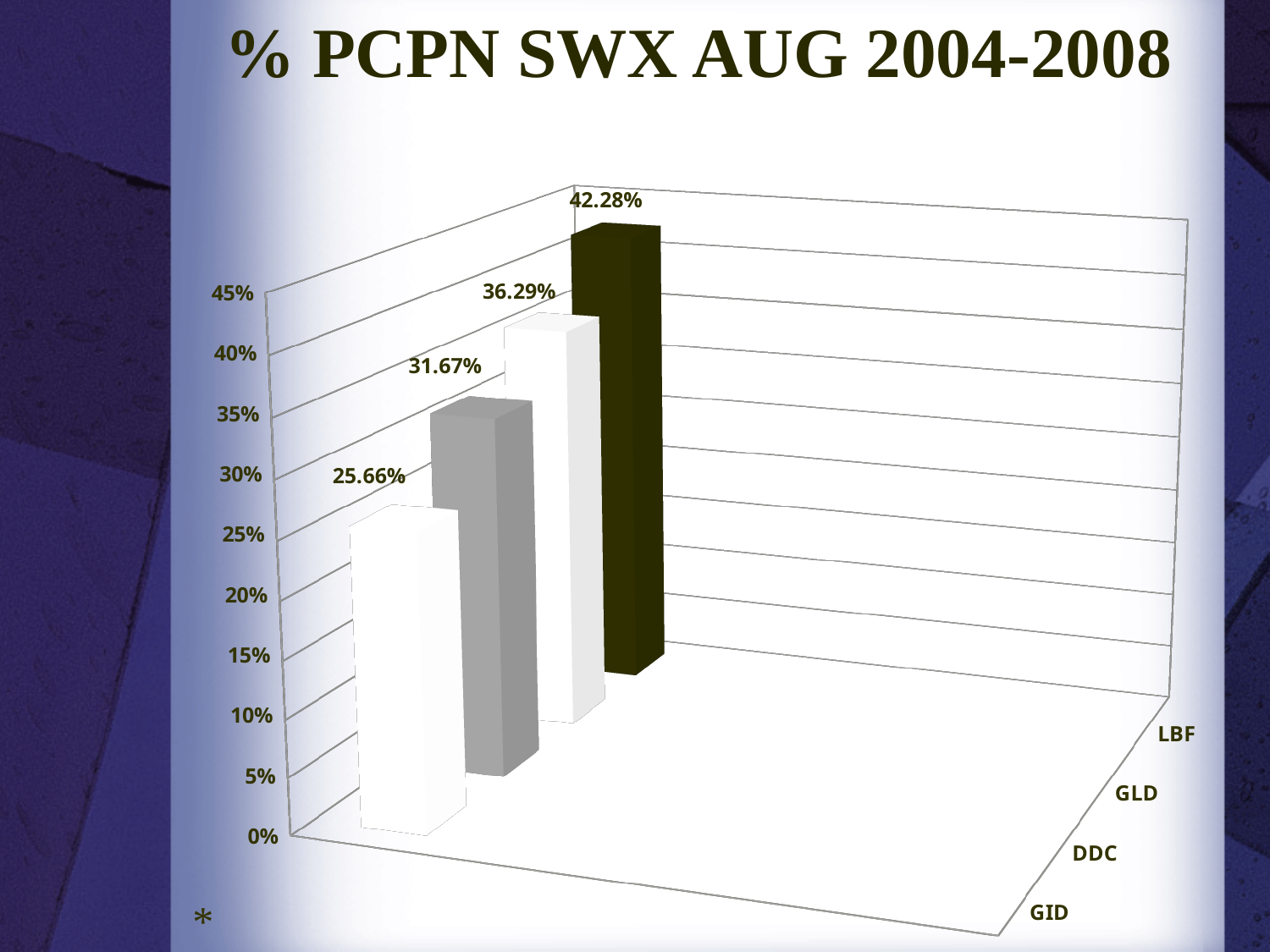
What is the value for LBF? 42.28% How many categories are shown in the chart? 4 Which category has the lowest value? GID What is the value for GID? 25.66% What is the difference between the values for GLD and DDC? 4.62 percentage points What kind of chart is shown on the slide? Bar chart Which is larger, the value for DDC or the value for GLD? GLD Which category has the highest value? LBF What is the value for DDC? 31.67% What is the value for GLD? 36.29% What is the difference between the values for LBF and GID? 16.62 percentage points What is the title of the chart? % PCPN SWX AUG 2004-2008